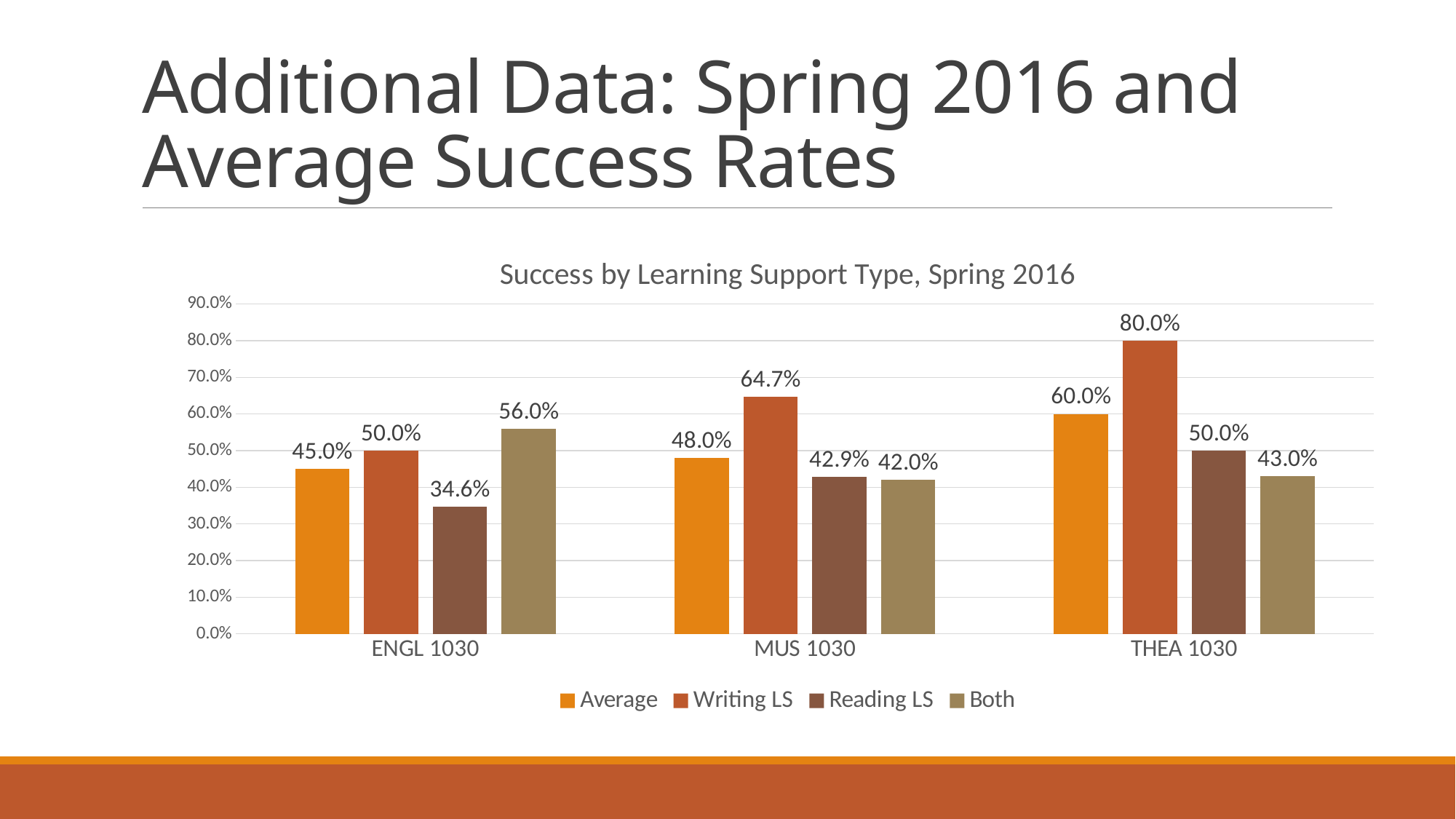
What is the title of the chart? Success by Learning Support Type, Spring 2016 Which course has the highest Writing LS success rate? THEA 1030 How many courses are shown on the x axis? 3 Which course has the lowest Reading LS success rate? ENGL 1030 What is the Both value for MUS 1030? 42.0% How many series does the legend list? 4 Which is larger for ENGL 1030, the Both value or the Average value? Both What is the Average success rate for THEA 1030? 60.0% What kind of chart is shown on the slide? Bar chart What is the Writing LS success rate for THEA 1030? 80.0% What is the Reading LS success rate for ENGL 1030? 34.6% What is the difference between the Writing LS and Average success rates for THEA 1030? 20.0%